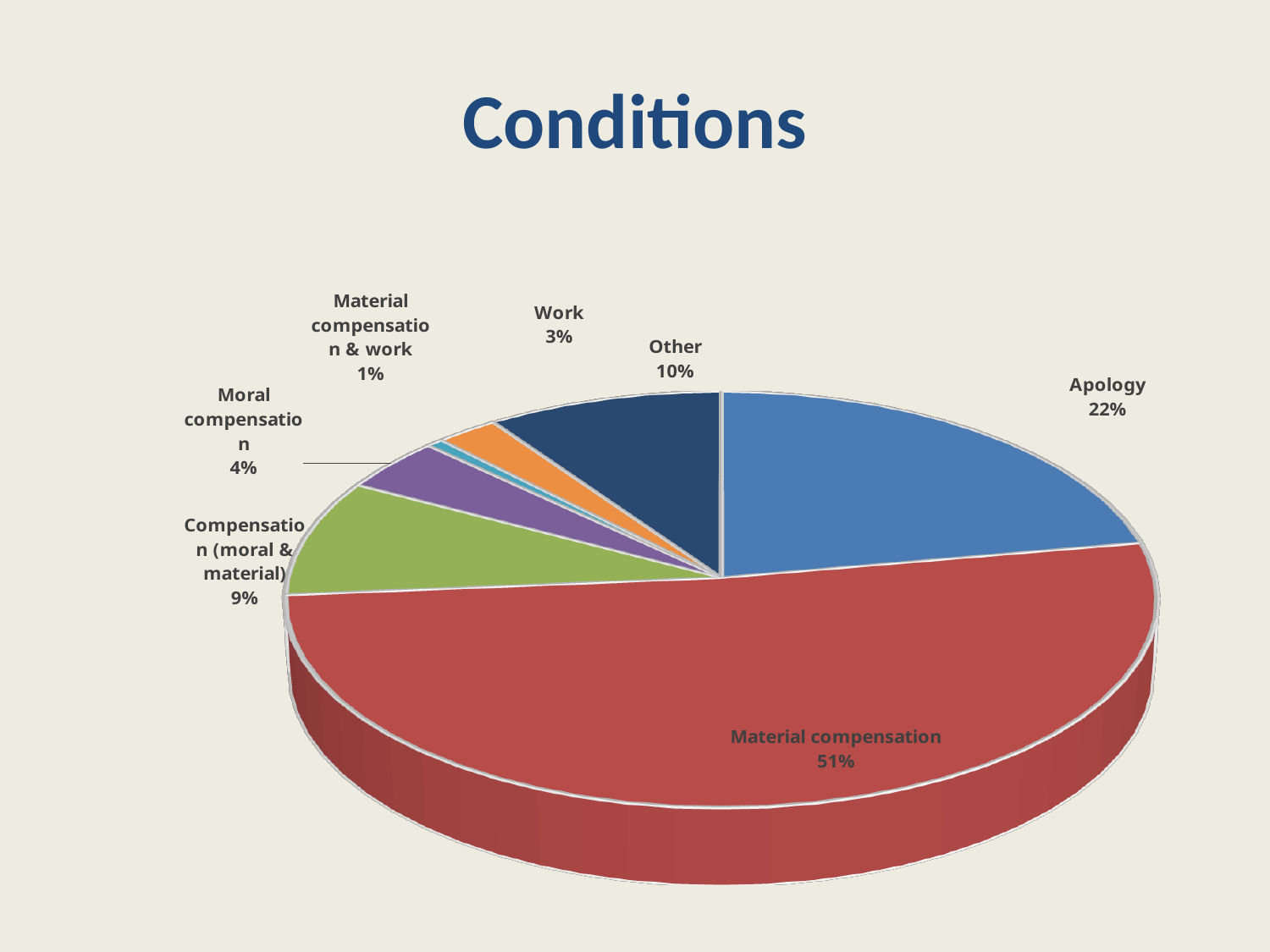
Which is larger, Compensation (moral & material) or Moral compensation? Compensation (moral & material) What type of chart is shown on the slide? pie chart What share of the pie does Material compensation have? 51% Which category has the largest slice of the pie? Material compensation What percentage is shown for Other? 10% What is the title of the chart? Conditions Which category has the smallest slice of the pie? Material compensation & work How many categories are shown in the pie chart? 7 What share of the pie does Apology have? 22% What percentage is shown for Work? 3% What is the difference in percentage points between Material compensation and Apology? 29 What is the combined percentage of Apology and Other? 32%